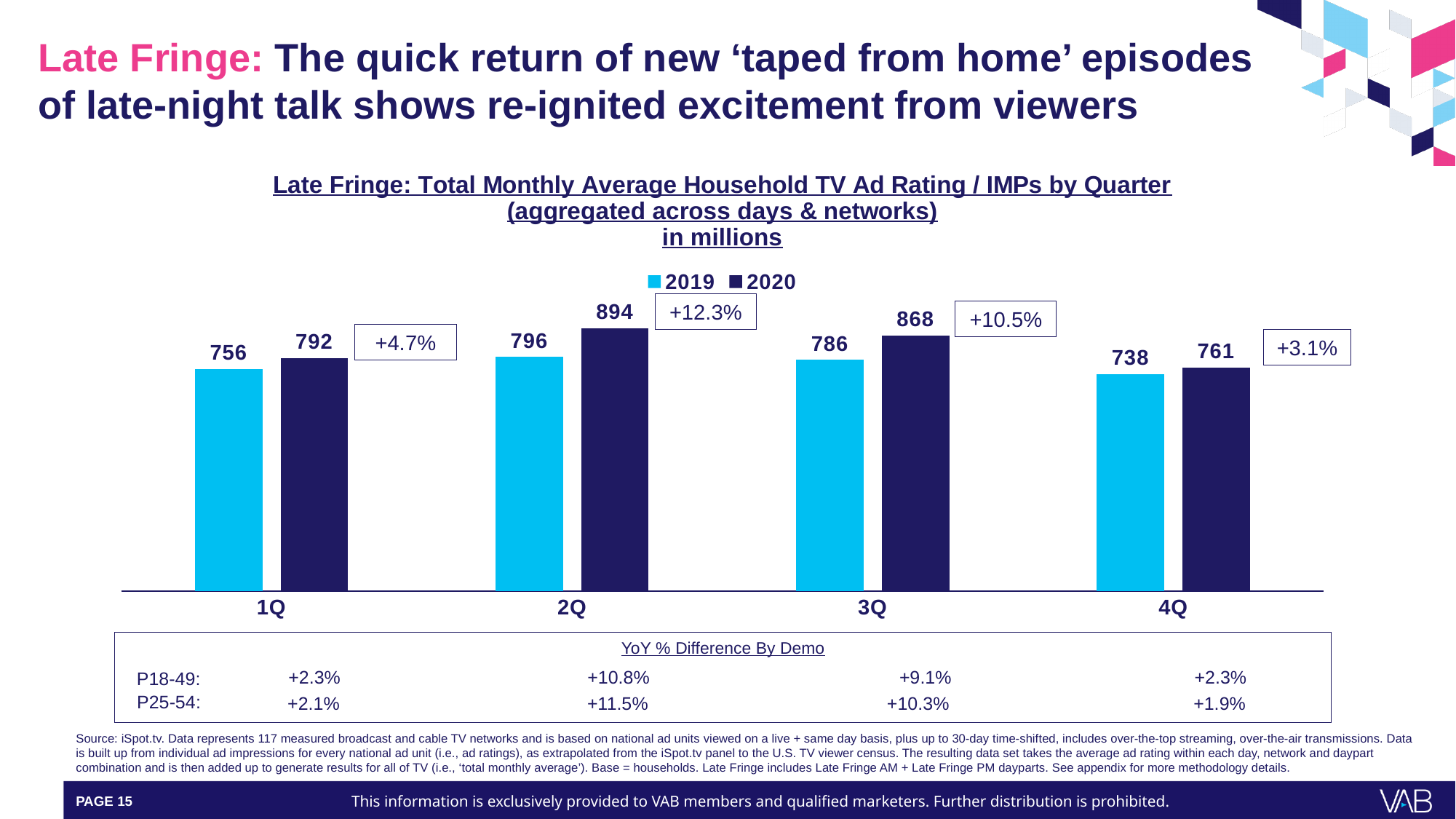
Which colour represents the 2020 series in the legend? Dark navy blue How many quarters are shown on the x axis? 4 What percentage change is shown in the box next to the 2Q bars? +12.3% Which quarter has the lowest 2019 value? 4Q Which quarter has the highest 2020 value? 2Q Which is larger, the 2019 value for 2Q or the 2019 value for 3Q? 2019 value for 2Q What is the 2019 value for 1Q? 756 How many series does the legend list? 2 What is the difference between the 2020 and 2019 values for 3Q? 82 What is the 2020 value for 4Q? 761 What is the 2020 value for 2Q? 894 What kind of chart is shown? Bar chart